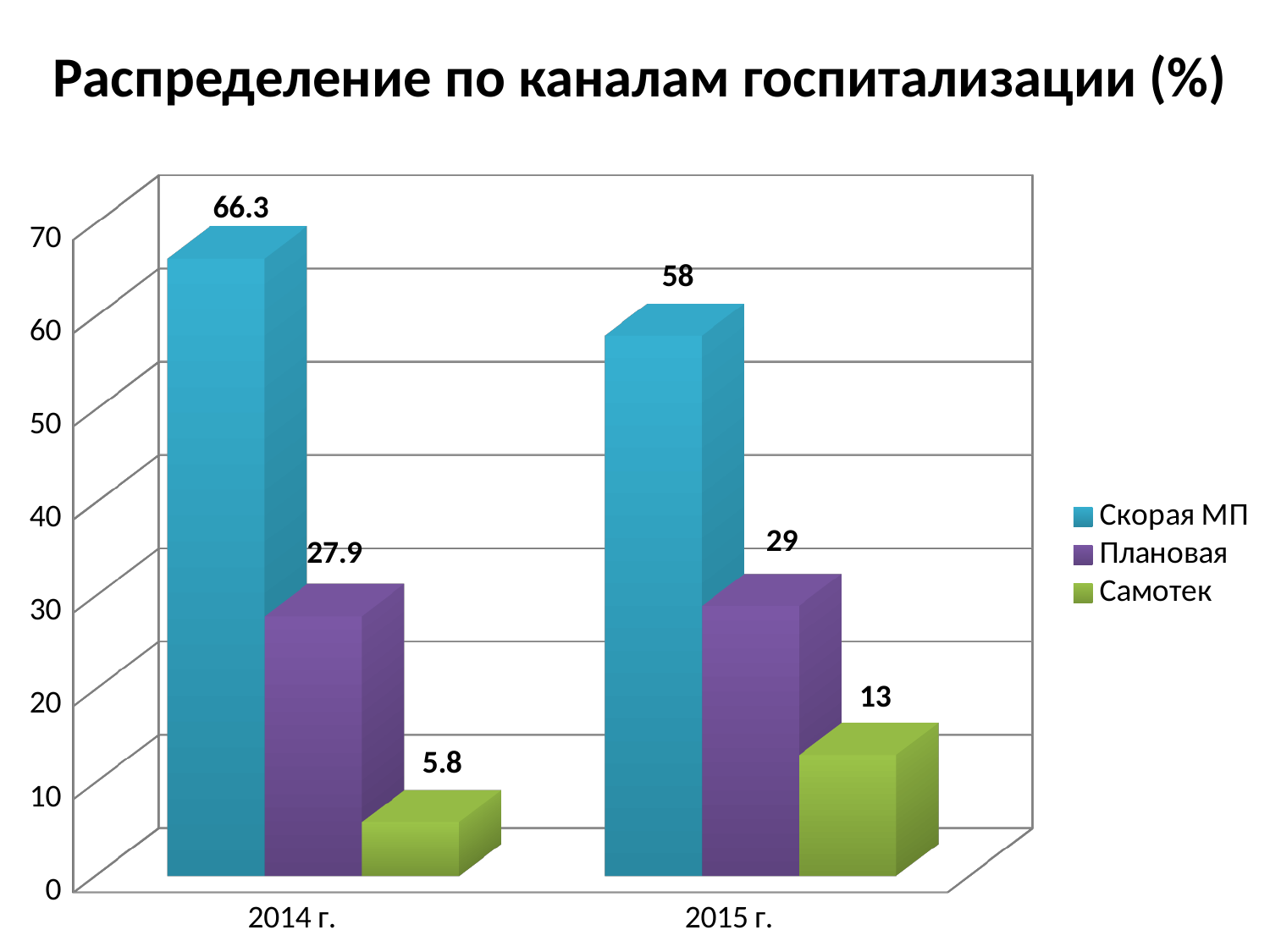
Which is larger: Плановая in 2014 г. or Плановая in 2015 г.? Плановая in 2015 г. What is the value for Самотек in 2014 г.? 5.8 What is the value for Плановая in 2015 г.? 29 What is the value for Скорая МП in 2014 г.? 66.3 How many series does the legend list? 3 What is the value for Скорая МП in 2015 г.? 58 What is the difference between the Скорая МП values for 2014 г. and 2015 г.? 8.3 Which series has the highest value in 2015 г.? Скорая МП What kind of chart is shown on the slide? Bar chart What is the difference between the Самотек values for 2015 г. and 2014 г.? 7.2 What is the title of the chart? Распределение по каналам госпитализации (%) Which series has the lowest value in 2014 г.? Самотек